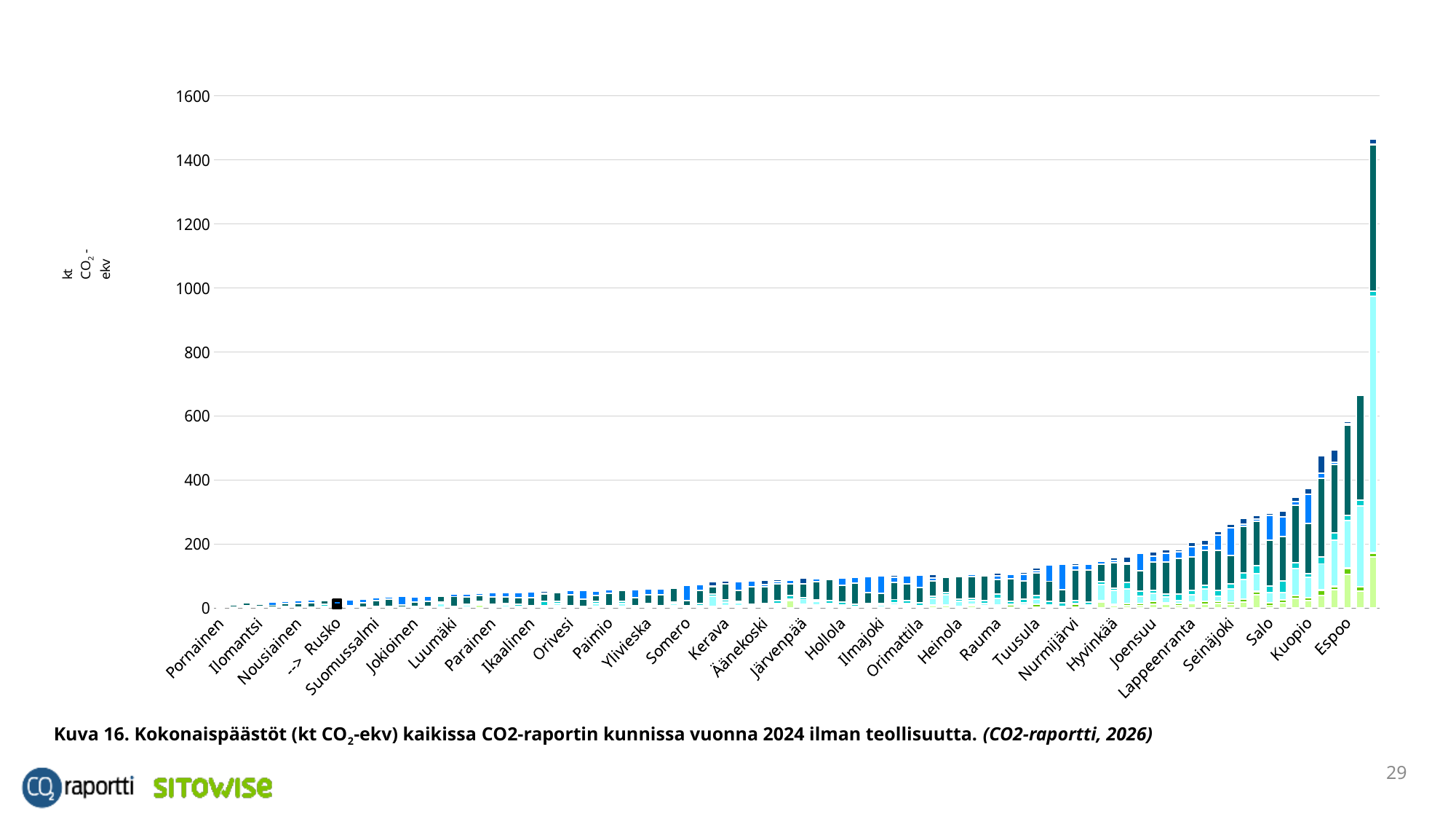
Do the bar totals rise or fall from left to right along the x axis? Rise Which has a larger total, Espoo or Kuopio? Espoo Is the total value for Joensuu greater or less than 400? less Is the total value for Salo greater or less than 400? less Which year do the emissions in the chart refer to, according to the caption? 2024 Which has a larger total, Seinäjoki or Pornainen? Seinäjoki What unit is shown on the y axis of the chart? kt CO2-ekv Is the total value for Kuopio greater or less than 400? less What kind of chart is shown on the slide? Bar chart (stacked) Which municipality has the lowest total emissions in the chart? Pornainen